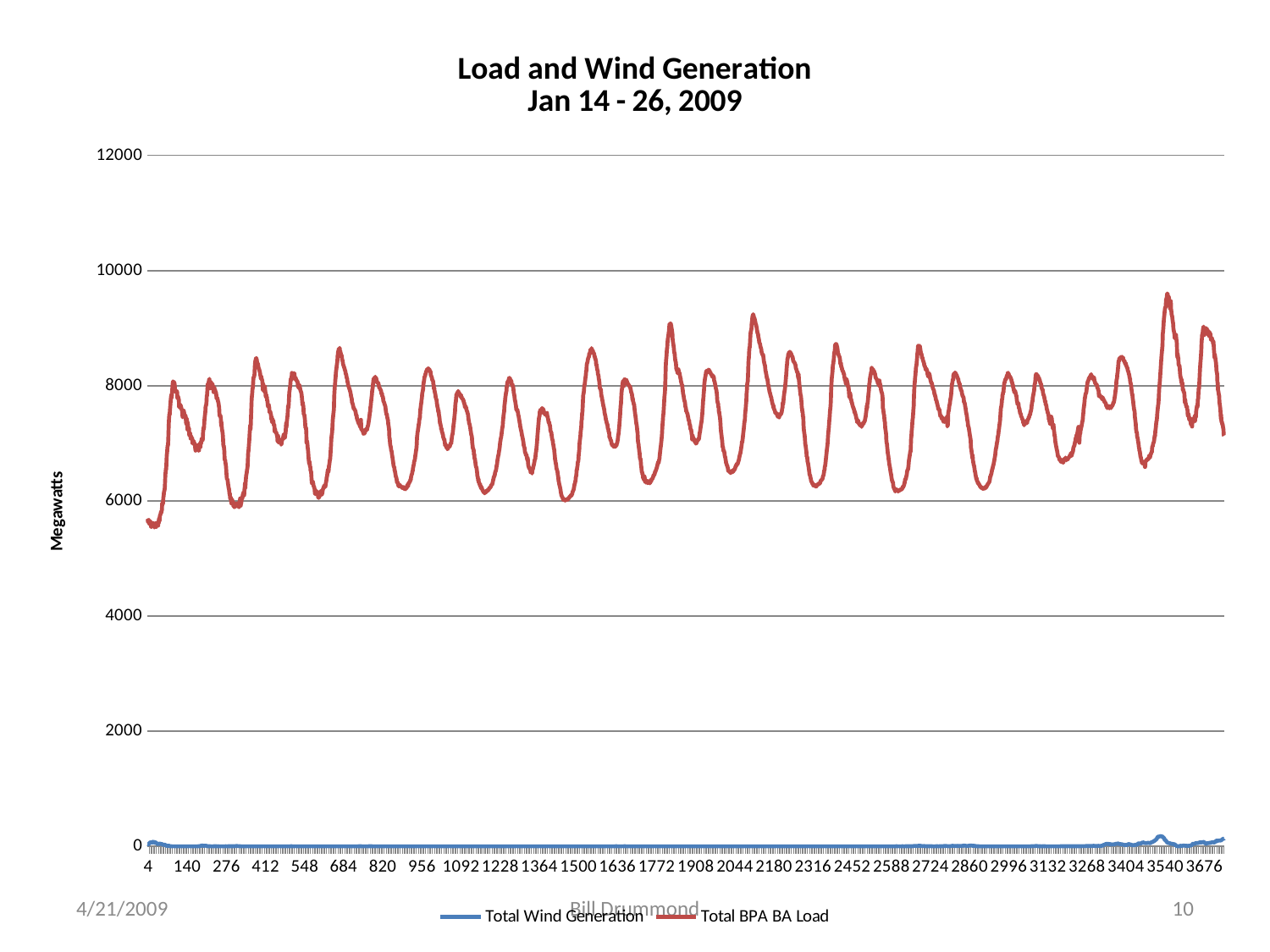
Which series has the higher values throughout the chart, Total Wind Generation or Total BPA BA Load? Total BPA BA Load Is the lowest value of Total BPA BA Load greater or less than 4000? greater What is the label on the vertical axis? Megawatts What kind of chart is shown on the slide? line chart Is the value for Total Wind Generation at x = 140 greater or less than 2000? less Is the highest value of Total Wind Generation greater or less than 2000? less What is the title of the chart? Load and Wind Generation Jan 14 - 26, 2009 What is the highest value shown on the vertical axis? 12000 How many series does the legend list? 2